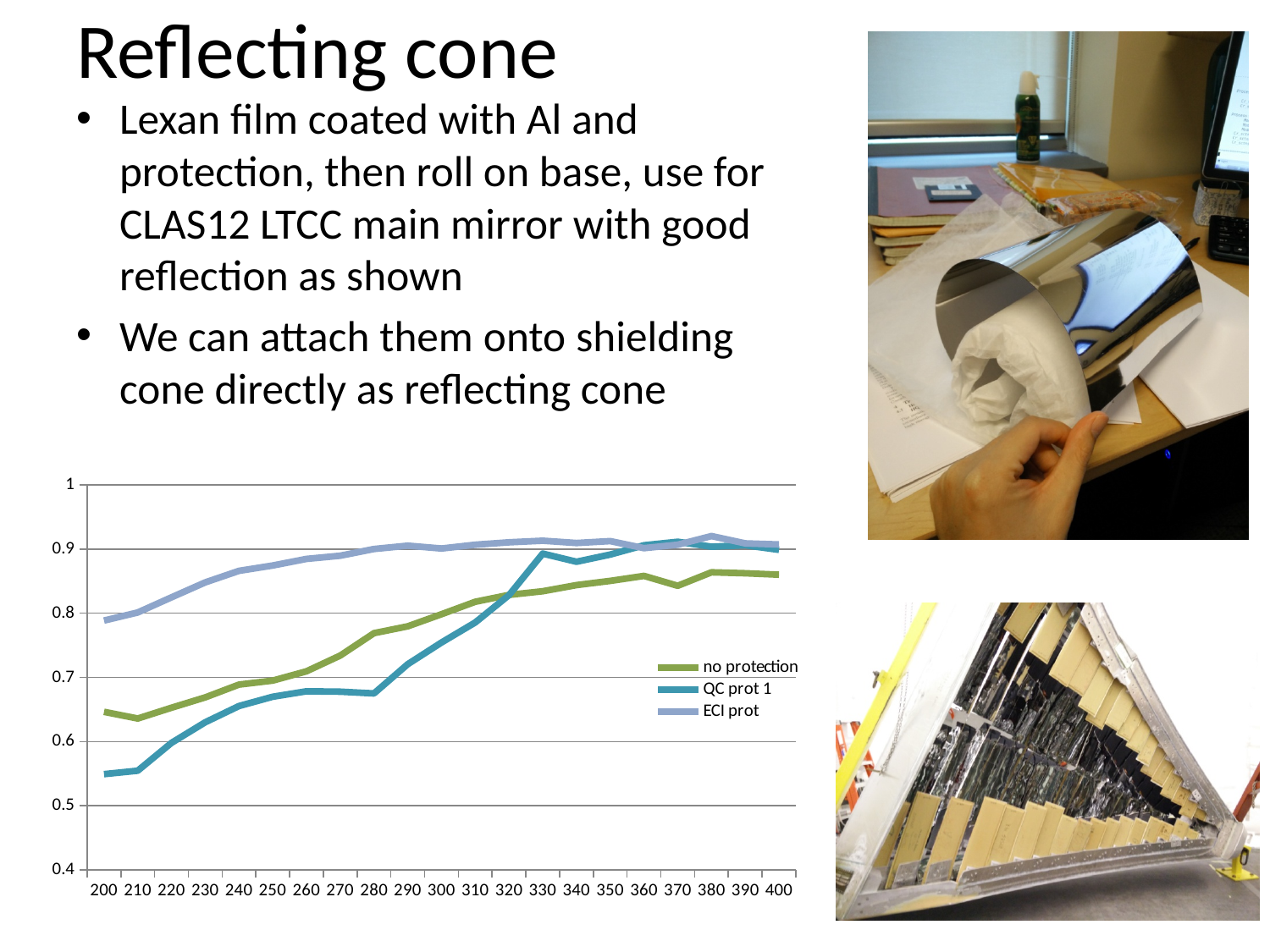
At x = 220, which series has the larger value, no protection or QC prot 1? no protection Is the value of no protection at x = 200 greater or less than 0.6? greater Does the no protection series generally rise or fall from x = 200 to x = 400? rise How many x-axis points are plotted on the chart (from 200 to 400)? 21 Is the value of ECI prot at x = 250 greater or less than 0.8? greater What kind of chart is shown on the slide? line chart How many series does the chart legend list? 3 Which series has the lowest value at x = 200? QC prot 1 Is the value of no protection at x = 400 greater or less than 0.9? less Which series has the highest value at x = 200? ECI prot At x = 330, which series has the larger value, QC prot 1 or no protection? QC prot 1